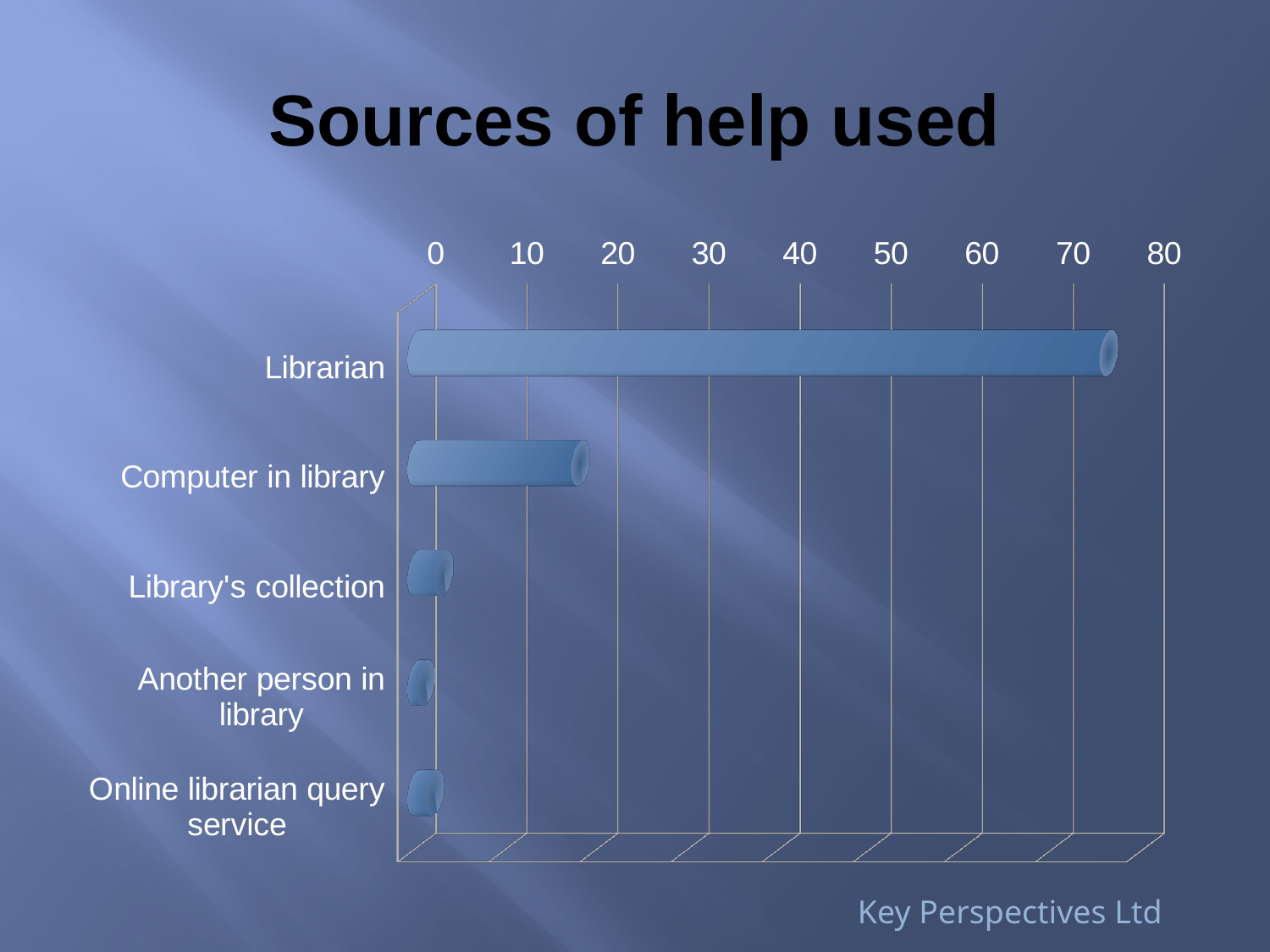
Is the value for Computer in library greater or less than 20? less How many categories are plotted in the chart? 5 What kind of chart is shown on the slide? bar chart Which is larger, the value for Computer in library or the value for Library's collection? Computer in library Is the value for Library's collection greater or less than 10? less What is the title of the chart? Sources of help used Is the value for Librarian greater or less than 70? greater What is the highest value shown on the chart's axis? 80 Which is larger, the value for Librarian or the value for Computer in library? Librarian Which source of help has the highest value? Librarian